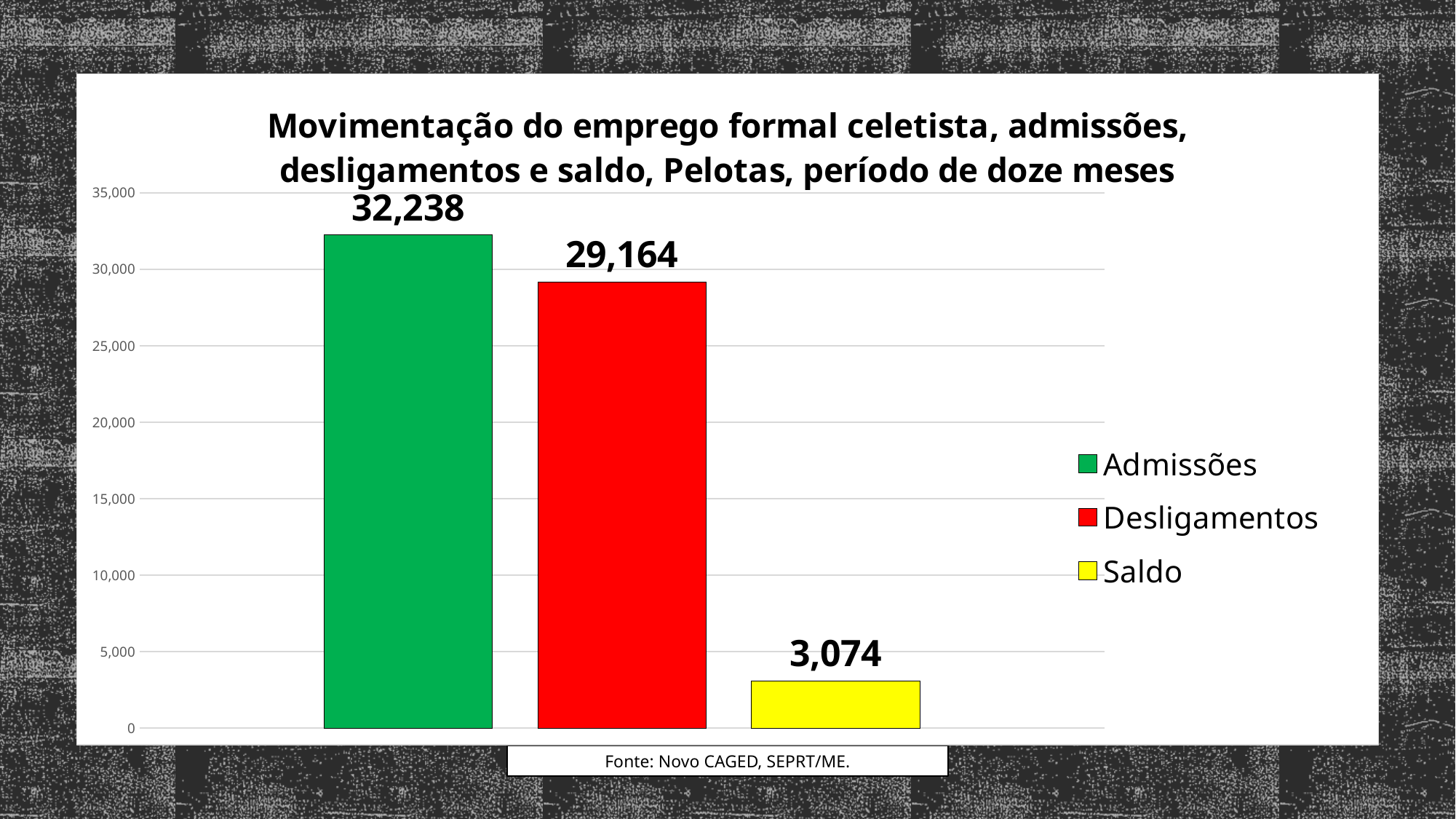
What is the value for Desligamentos? 29,164 Which series has the lowest value? Saldo How many bars are plotted in the chart? 3 What is the value for Saldo? 3,074 How many series does the legend list? 3 Which is larger, Desligamentos or Saldo? Desligamentos Is the value for Desligamentos greater or less than 30,000? less Which series has the highest value? Admissões What is the value for Admissões? 32,238 What is the difference between Admissões and Desligamentos? 3,074 What kind of chart is shown on the slide? bar chart What colour is the bar for Saldo? yellow